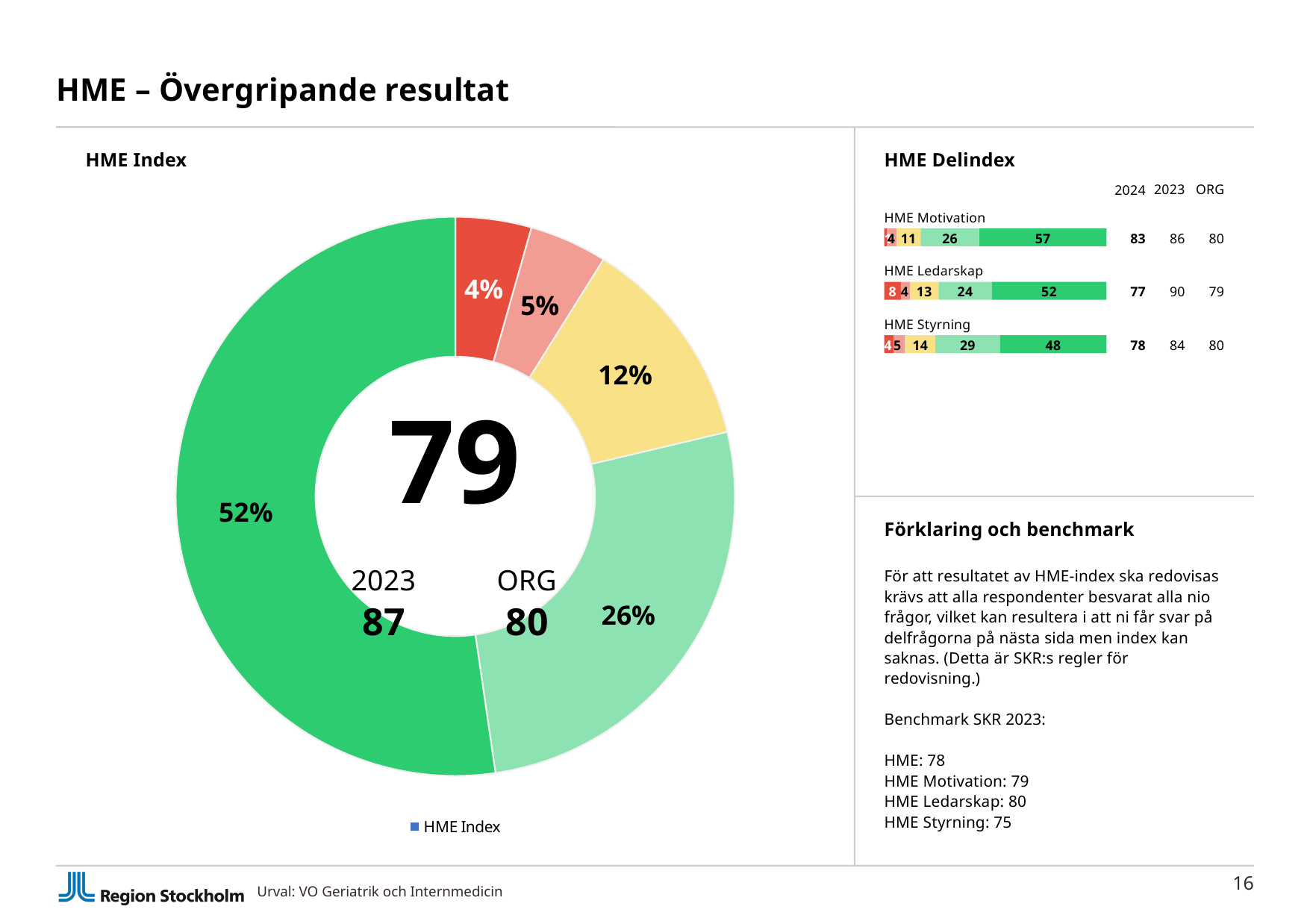
What is the HME Index value shown in the centre of the donut chart? 79 What kind of chart is the HME Index chart? Donut (pie) chart In the HME Index donut chart, how many slices does the donut have? 5 In the HME Index donut chart, what is the share of the largest (dark green) slice? 52% In the HME Delindex bars, what is the 2024 value for HME Ledarskap? 77 In the HME Index donut chart, what is the share of the smallest (red) slice? 4% In the HME Index donut chart, what is the ORG value shown in the centre? 80 In the HME Index donut chart, what percentage is shown on the yellow slice? 12% In the HME Index donut chart, what is the difference between the dark green slice (52%) and the light green slice (26%)? 26% In the HME Delindex bars, which delindex has the highest 2024 value? HME Motivation In the HME Index donut chart, what was the 2023 value shown in the centre? 87 In the HME Index donut chart, what percentage is shown on the light green slice? 26%